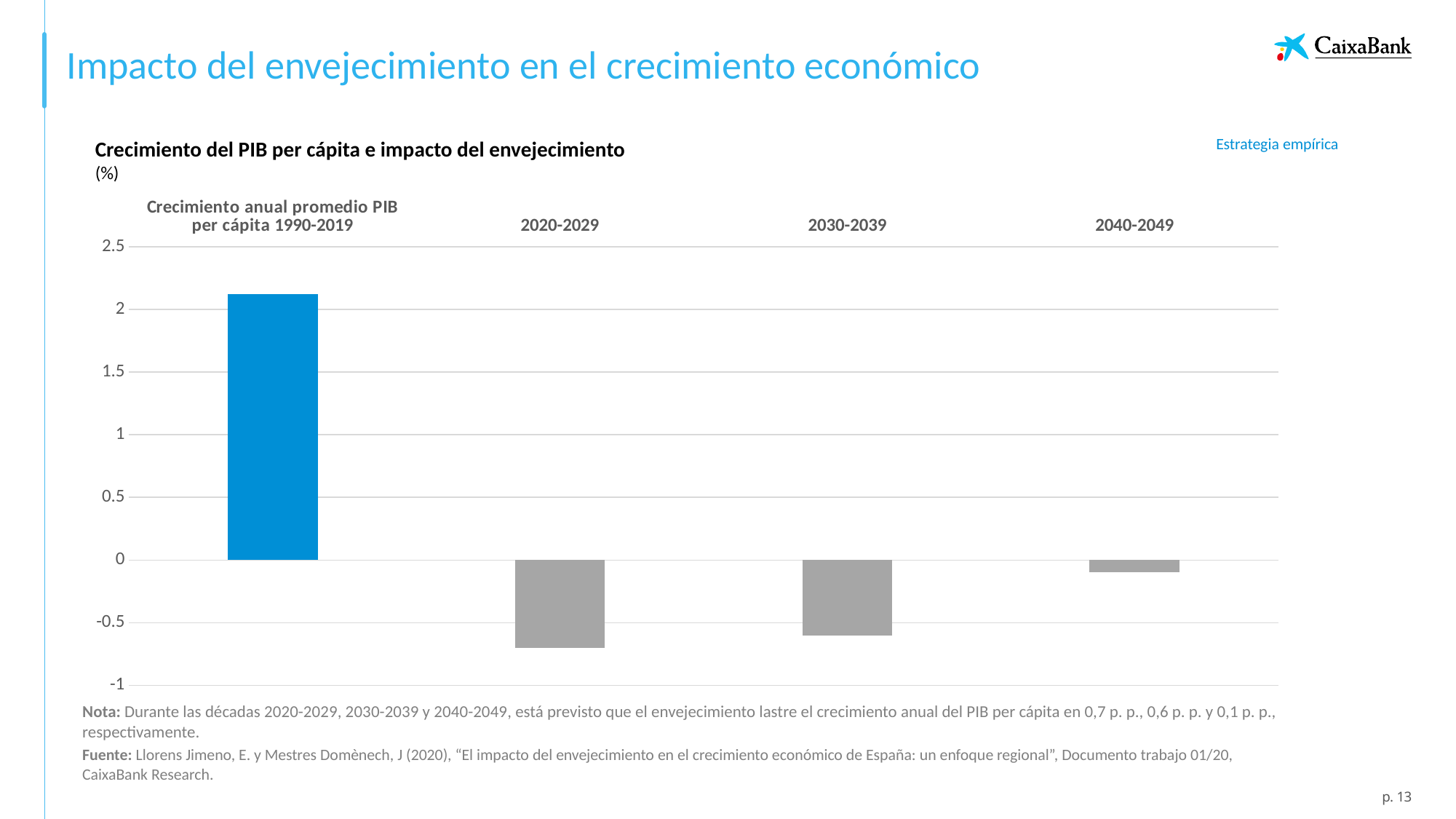
Is the value for 2020-2029 greater or less than -0.5? less What colour is the bar for 'Crecimiento anual promedio PIB per cápita 1990-2019'? Blue Which category has the highest value in the chart? Crecimiento anual promedio PIB per cápita 1990-2019 Is the value for 2040-2049 greater or less than -0.5? greater What kind of chart is shown on the slide? Bar chart How many bars in the chart have negative values? 3 Is the value for 'Crecimiento anual promedio PIB per cápita 1990-2019' greater or less than 1.5? greater What is the title of the chart? Crecimiento del PIB per cápita e impacto del envejecimiento Do the values rise or fall from 2020-2029 to 2040-2049? rise Which category has the lowest value in the chart? 2020-2029 How many categories (bars) does the chart show? 4 Which is larger, the value for 2030-2039 or the value for 2040-2049? 2040-2049